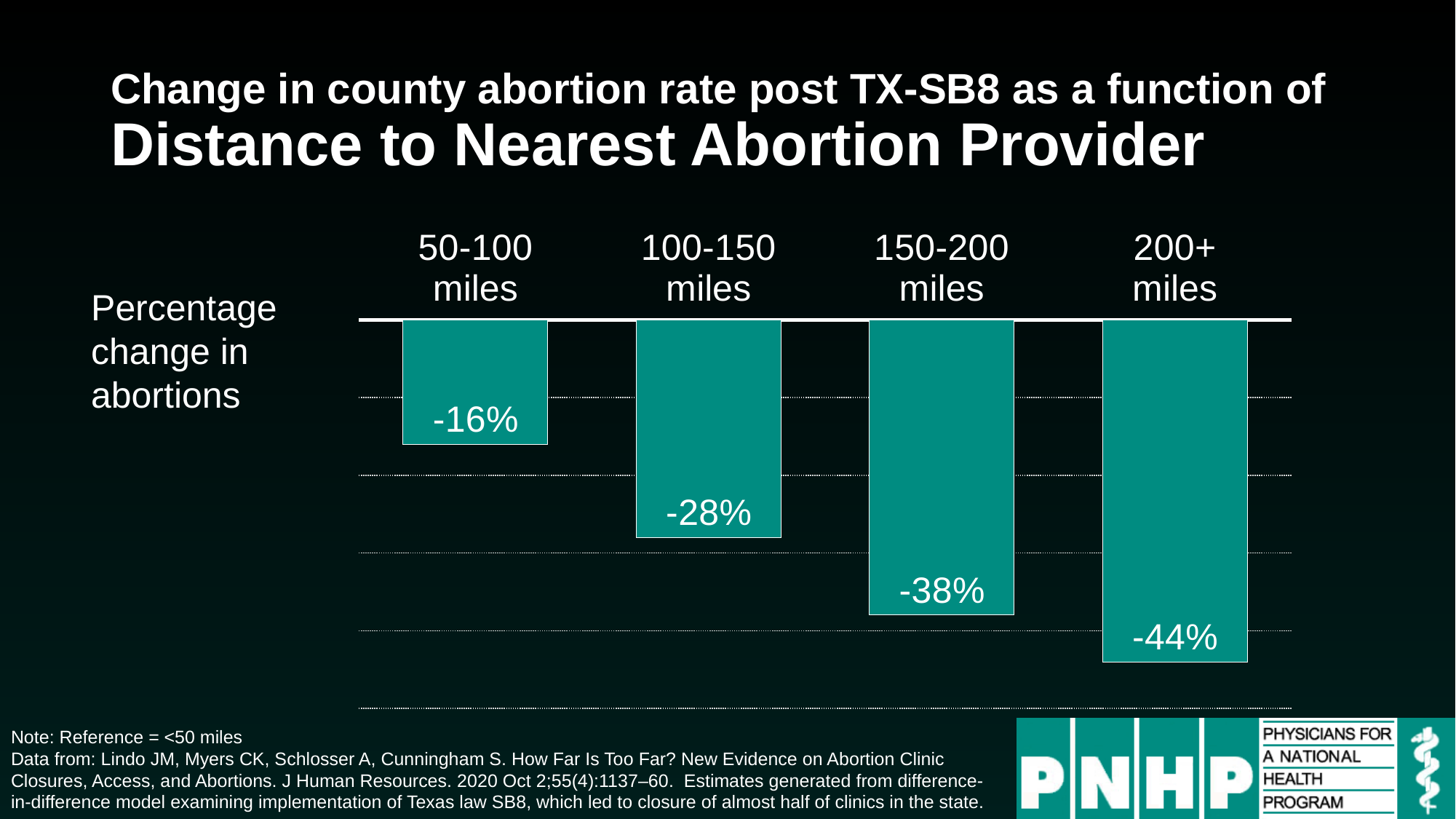
Which distance category shows the largest decrease in abortions? 200+ miles What is the percentage change in abortions for counties 200+ miles from the nearest provider? -44% As distance to the nearest abortion provider increases, do the percentage changes in abortions become more negative or less negative? More negative What type of chart is shown on the slide? Bar chart What is the difference in percentage points between the 200+ miles value and the 50-100 miles value? 28 percentage points How many distance categories are plotted in the chart? 4 Which category shows a larger decrease in abortions: 100-150 miles or 150-200 miles? 150-200 miles What value is shown for the 150-200 miles bar? -38% Which distance category shows the smallest decrease in abortions? 50-100 miles What is the difference in percentage points between the 150-200 miles value and the 100-150 miles value? 10 percentage points What is the percentage change in abortions for counties 50-100 miles from the nearest abortion provider? -16% What is the percentage change in abortions for the 100-150 miles category? -28%